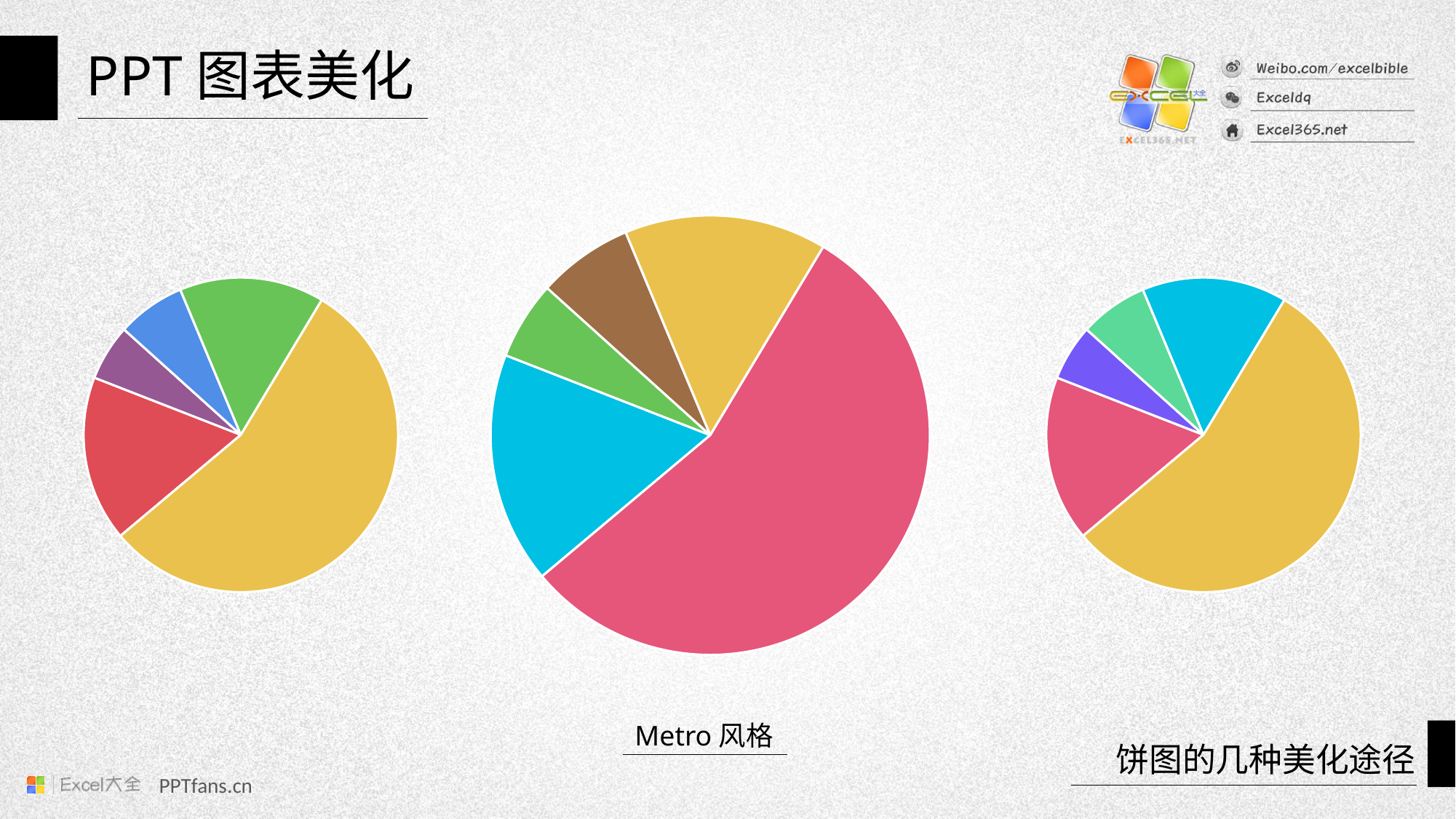
How many slices does the left pie chart have? 5 How many slices does the middle pie chart (Metro 风格) have? 5 How many slices does the right pie chart have? 5 What is the caption written under the middle pie chart? Metro 风格 What kind of chart is the left chart on the slide? pie chart In the right pie chart, which colour slice is the largest? yellow How many pie charts are shown on the slide? 3 In the left pie chart, which colour slice is the largest? yellow In the left pie chart, which is larger, the yellow slice or the red slice? yellow In the middle pie chart (Metro 风格), which is larger, the cyan slice or the brown slice? cyan In the middle pie chart (Metro 风格), which colour slice is the largest? pink What kind of chart is the middle chart labelled Metro 风格? pie chart